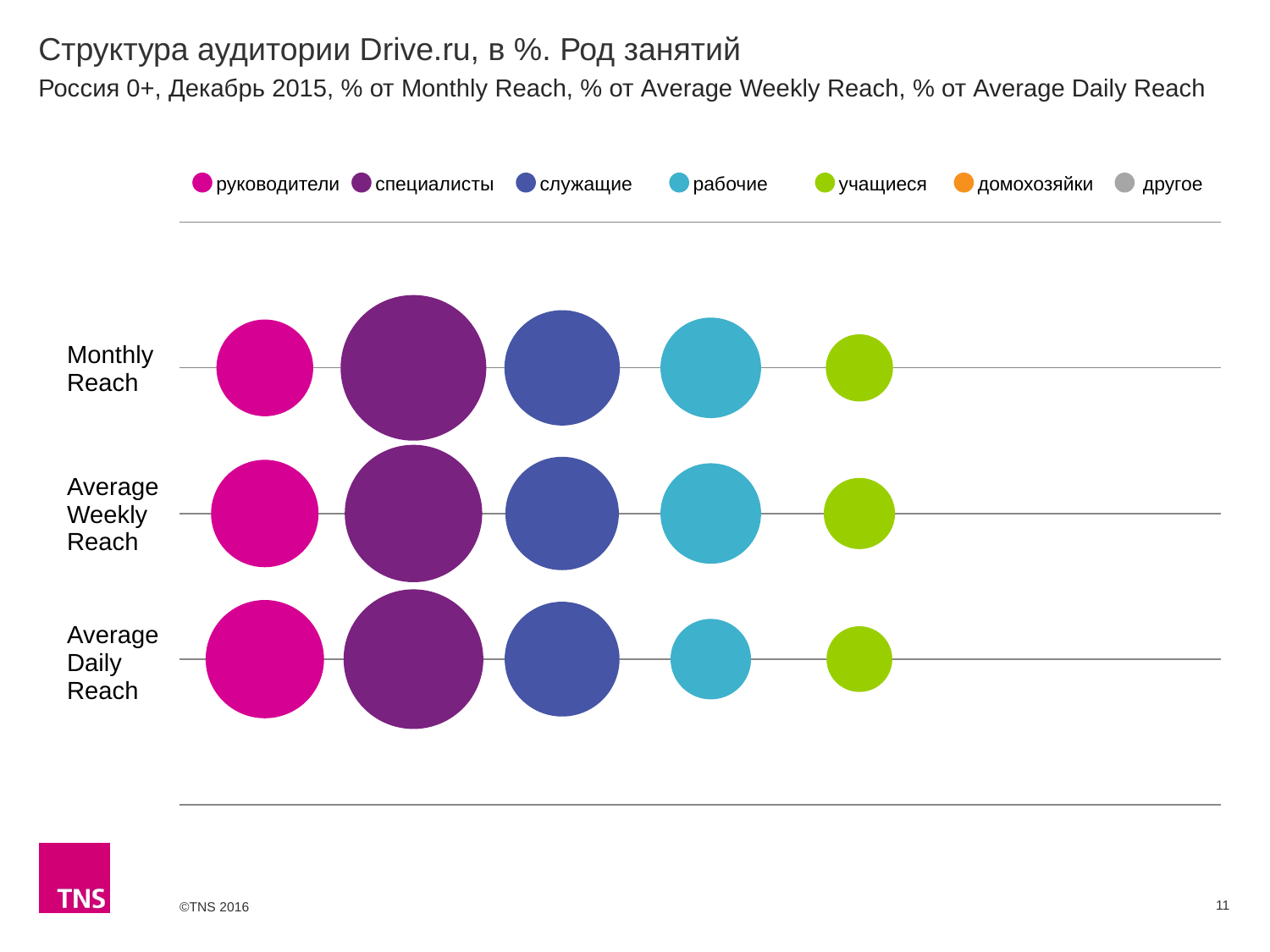
Which legend entry is shown in orange? домохозяйки Which occupation group has the largest bubble in the Average Daily Reach row? специалисты How many reach categories (rows) are plotted on the chart? 3 Which occupation group has the largest bubble in the Monthly Reach row? специалисты What is the label of the bottom row of the chart? Average Daily Reach What kind of chart is shown on the slide? Bubble chart In the Monthly Reach row, which is larger: the bubble for специалисты or the bubble for учащиеся? специалисты What is the title of the chart on the slide? Структура аудитории Drive.ru, в %. Род занятий In the Average Daily Reach row, which is larger: the bubble for руководители or the bubble for рабочие? руководители In the Monthly Reach row, which is larger: the bubble for служащие or the bubble for учащиеся? служащие Among the visible bubbles in the Average Weekly Reach row, which occupation group has the smallest? учащиеся How many series does the legend list? 7